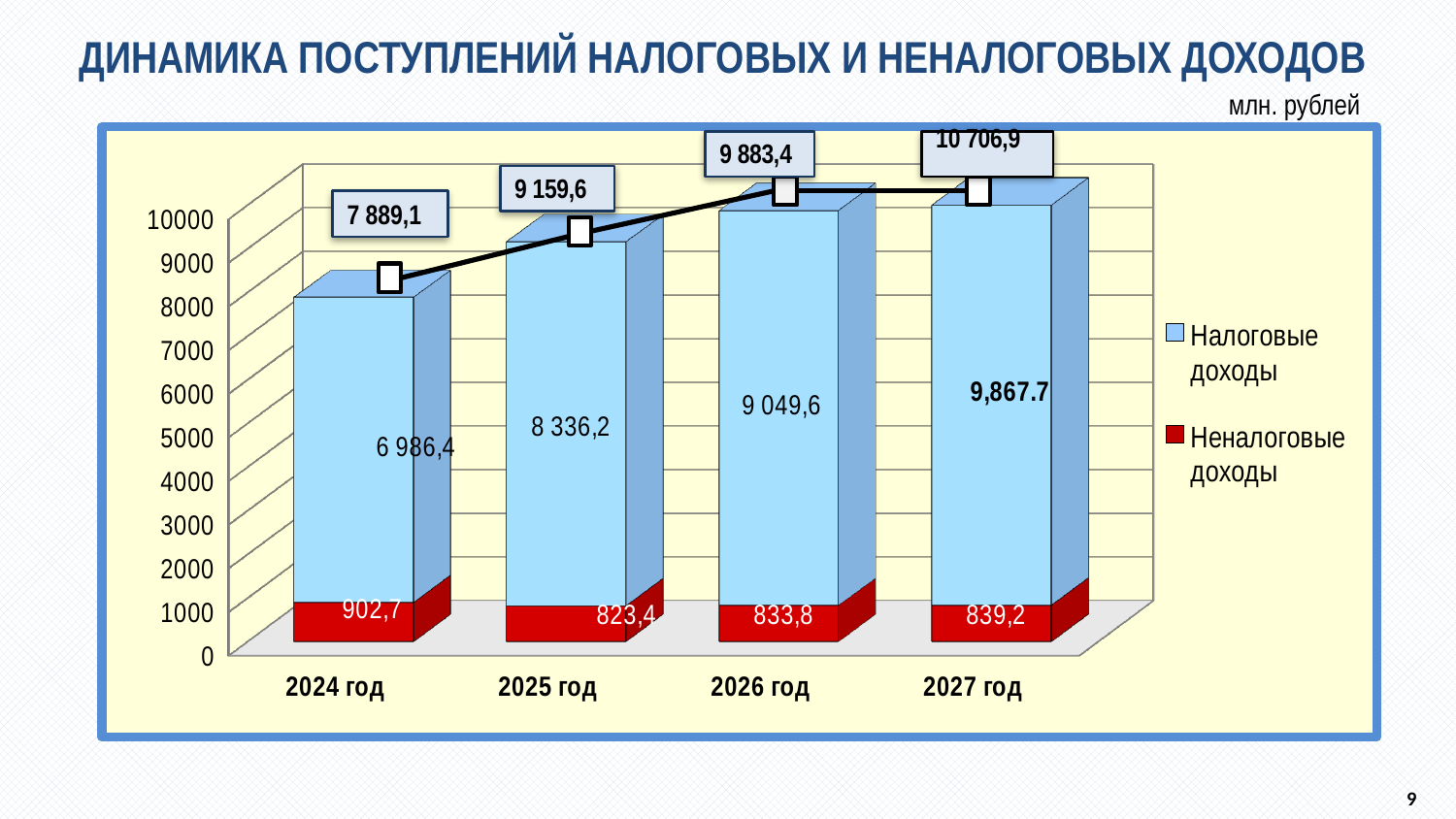
What is the value of Налоговые доходы for 2025 год? 8 336,2 Which year has the lowest Неналоговые доходы? 2025 год What is the value of Неналоговые доходы for 2024 год? 902,7 How many years are shown on the x axis? 4 Do the totals rise or fall from 2024 год to 2027 год? Rise How many series does the legend list? 2 Which year has the highest Налоговые доходы? 2027 год Which is larger: Неналоговые доходы in 2026 год or in 2027 год? 2027 год What kind of chart is shown on the slide? Stacked bar chart with a line What is the value of Налоговые доходы for 2026 год? 9 049,6 What is the difference between the totals for 2025 год and 2024 год? 1 270,5 What total is shown above the bar for 2027 год? 10 706,9